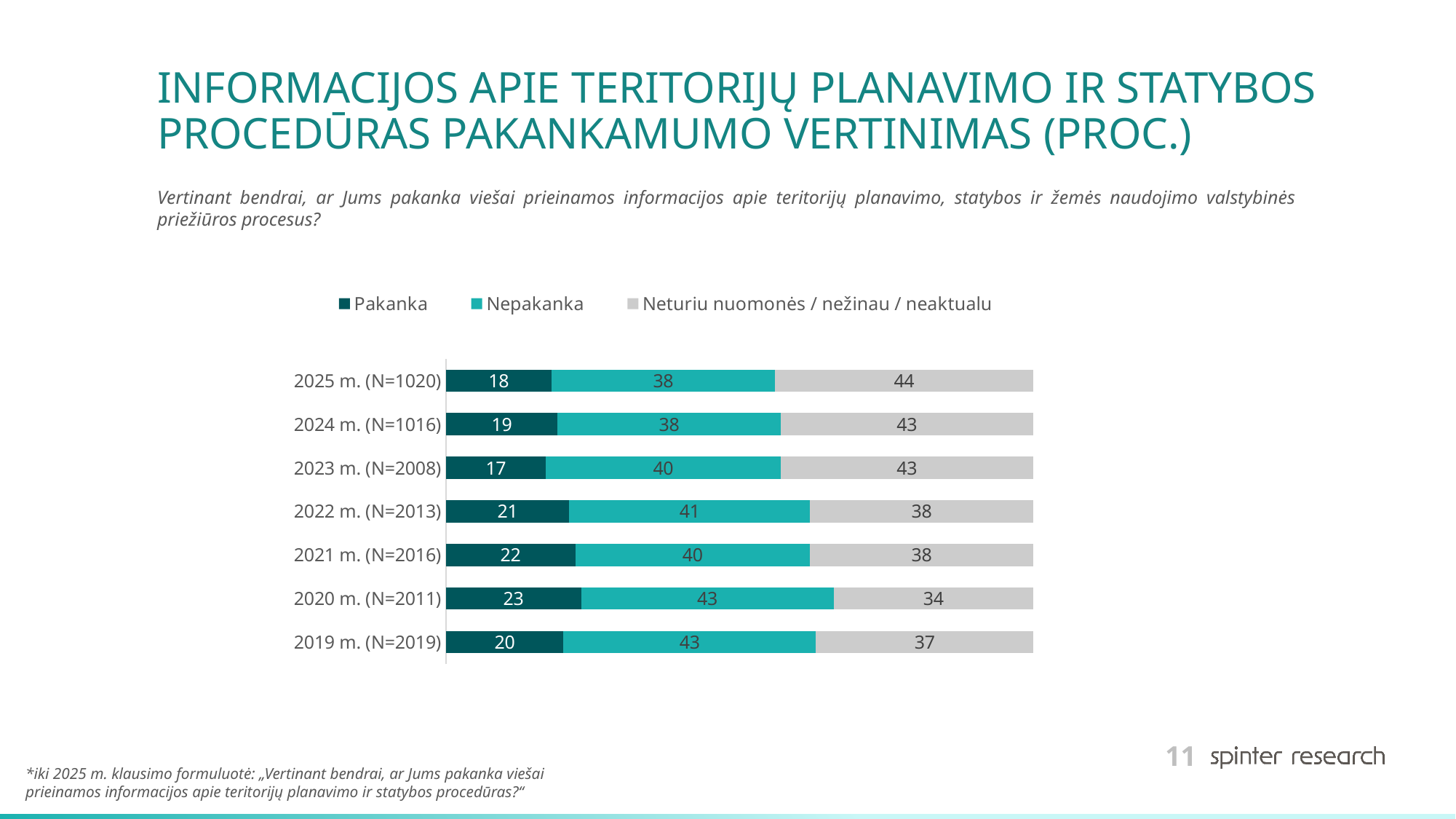
What kind of chart is shown on the slide? Stacked bar chart Which series is shown in grey in the chart? Neturiu nuomonės / nežinau / neaktualu What is the value for "Neturiu nuomonės / nežinau / neaktualu" in 2020 m. (N=2011)? 34 What is the value for "Nepakanka" in 2022 m. (N=2013)? 41 What is the total of the stacked bar for 2021 m. (N=2016)? 100 Which is larger: the "Nepakanka" value for 2019 m. (N=2019) or for 2024 m. (N=1016)? 2019 m. (N=2019) What is the value for "Pakanka" in 2025 m. (N=1020)? 18 How many years (categories) are shown in the chart? 7 In which year is the "Pakanka" value lowest? 2023 m. (N=2008) In which year is the "Pakanka" value highest? 2020 m. (N=2011) What is the difference between the "Neturiu nuomonės / nežinau / neaktualu" values for 2025 m. (N=1020) and 2020 m. (N=2011)? 10 How many series does the legend list? 3